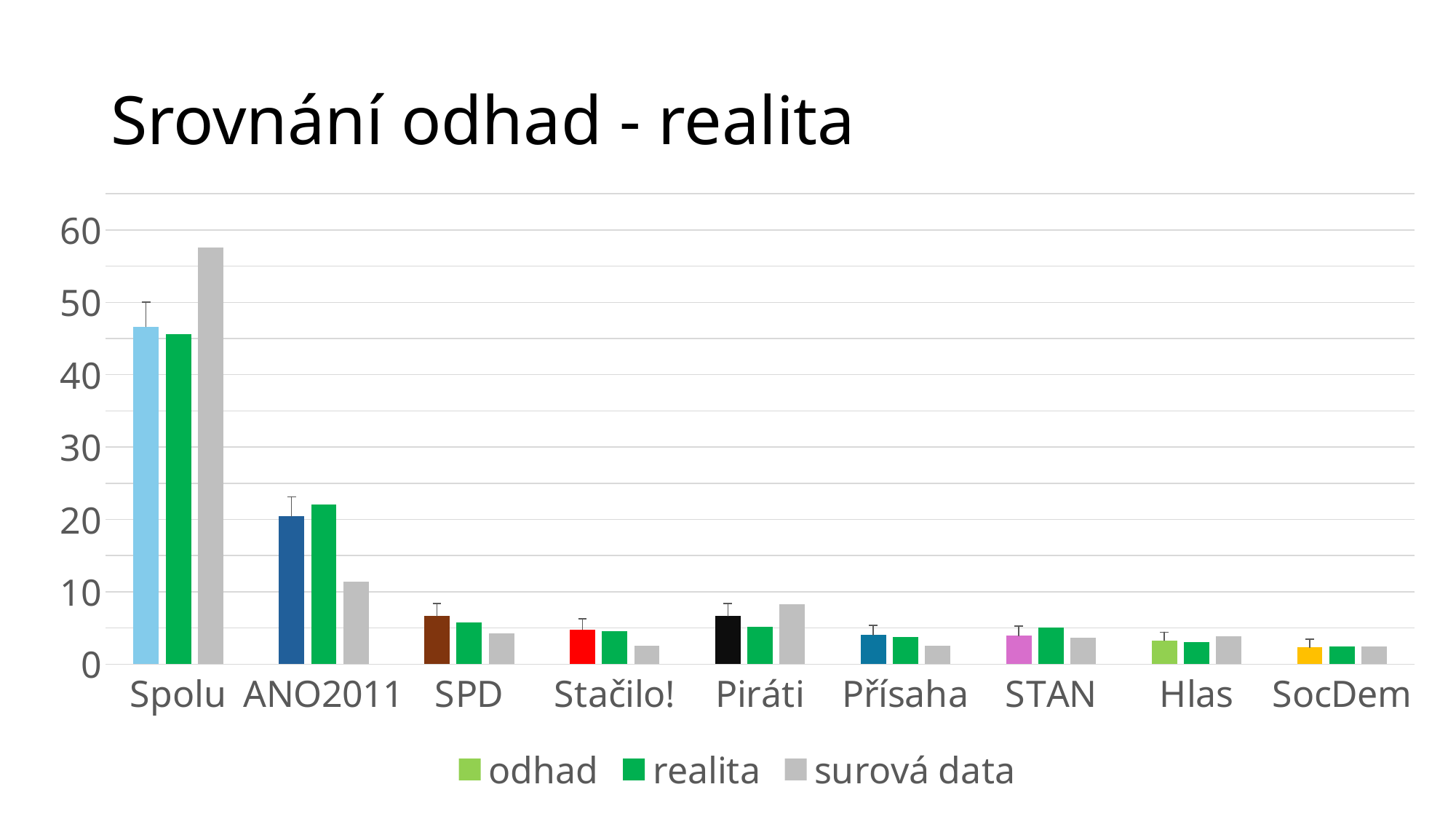
Which colour represents the 'surová data' series in the legend? grey Which category has the highest 'realita' value? Spolu For ANO2011, which is larger: the 'realita' value or the 'surová data' value? realita What kind of chart is shown on the slide? bar chart Is the 'surová data' value for Spolu greater or less than 50? greater What is the title of the chart? Srovnání odhad - realita How many series does the legend list? 3 For Piráti, which is larger: the 'odhad' value or the 'surová data' value? surová data Which category has the highest 'surová data' value? Spolu Is the 'realita' value for ANO2011 greater or less than 20? greater Is the 'surová data' value for Piráti greater or less than 10? less How many categories (parties) are shown on the x axis? 9